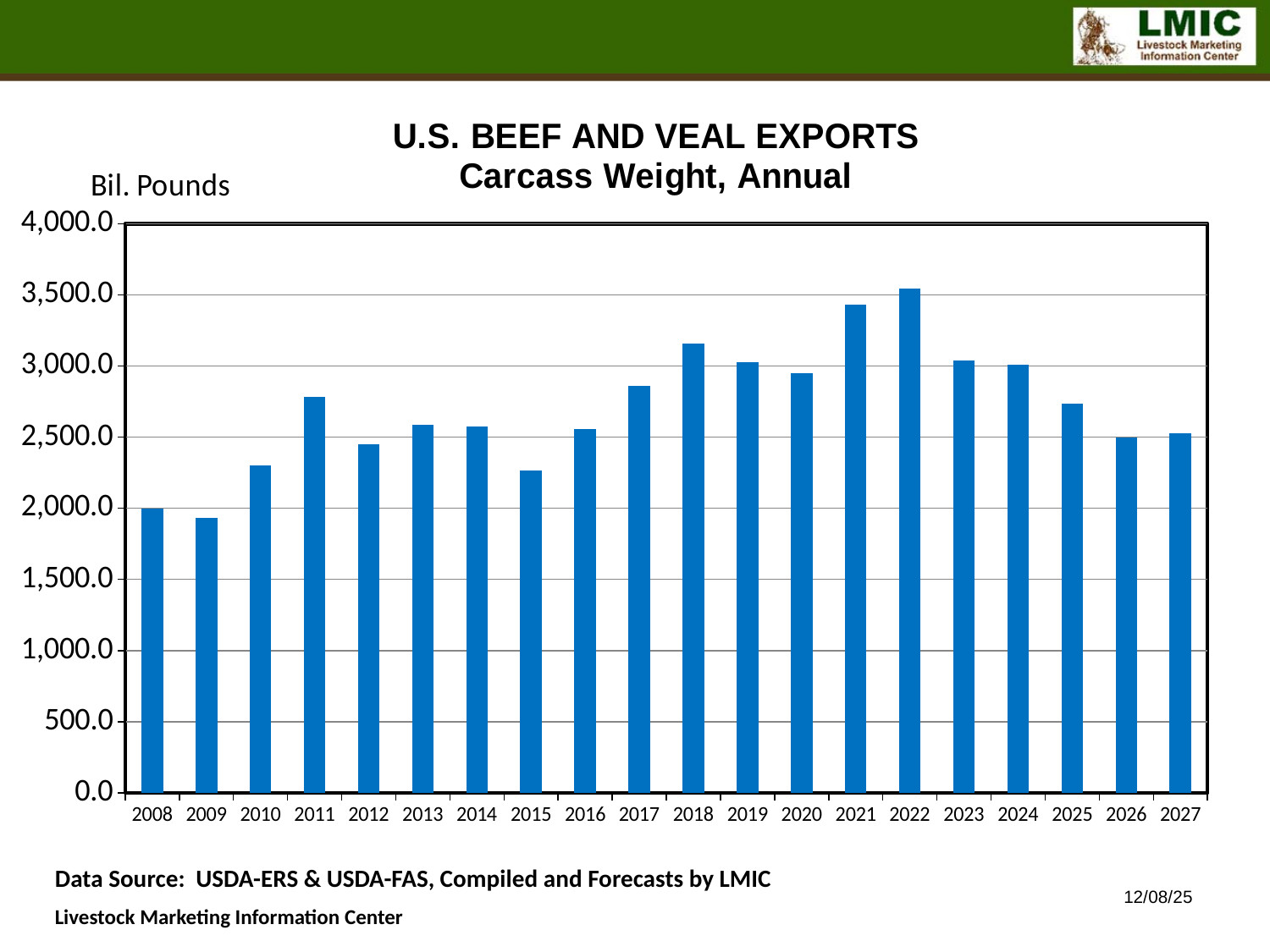
Is the value for 2009 greater or less than 2,000.0? less Do the values rise or fall from 2022 to 2026? fall Which year has the larger value, 2021 or 2018? 2021 Which year has the highest value for U.S. beef and veal exports? 2022 Is the value for 2021 greater or less than 3,000.0? greater How many years are plotted on the x axis of the chart? 20 Which year has the lowest value for U.S. beef and veal exports? 2009 What kind of chart is shown on the slide? bar chart What unit is shown on the y axis label of the chart? Bil. Pounds Is the value for 2015 greater or less than 2,500.0? less Which year has the larger value, 2011 or 2012? 2011